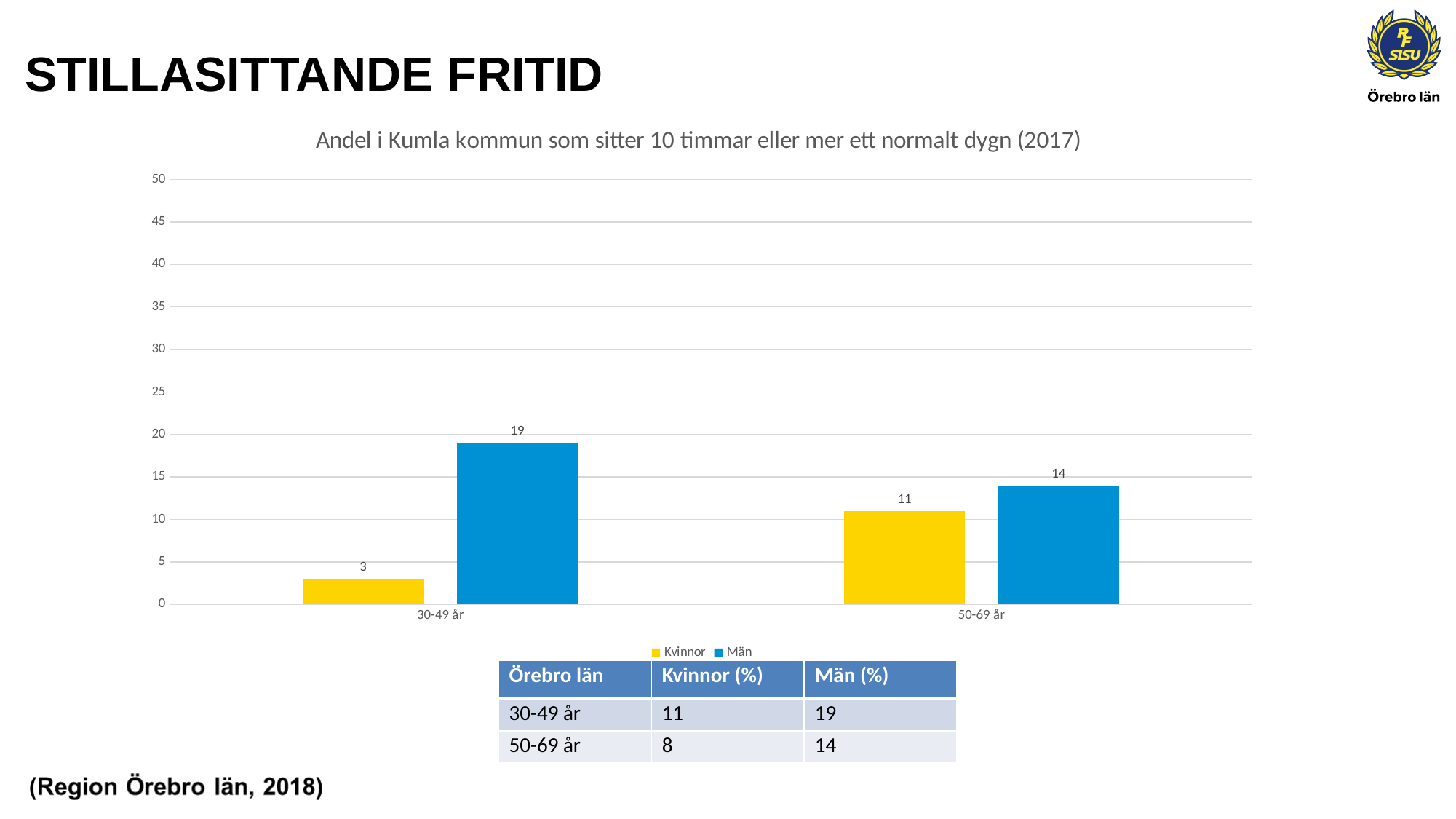
How many series does the legend list? 2 What is the value for Män in the 30-49 år category? 19 What is the difference between Män and Kvinnor in the 30-49 år category? 16 Which bar has the lowest value in the chart? Kvinnor, 30-49 år How many age categories are shown on the x axis? 2 Which bar has the highest value in the chart? Män, 30-49 år Which is larger: Kvinnor in 50-69 år or Kvinnor in 30-49 år? Kvinnor in 50-69 år What is the value for Män in the 50-69 år category? 14 What is the value for Kvinnor in the 30-49 år category? 3 What is the difference between Män and Kvinnor in the 50-69 år category? 3 What type of chart is shown on the slide? Bar chart What is the value for Kvinnor in the 50-69 år category? 11